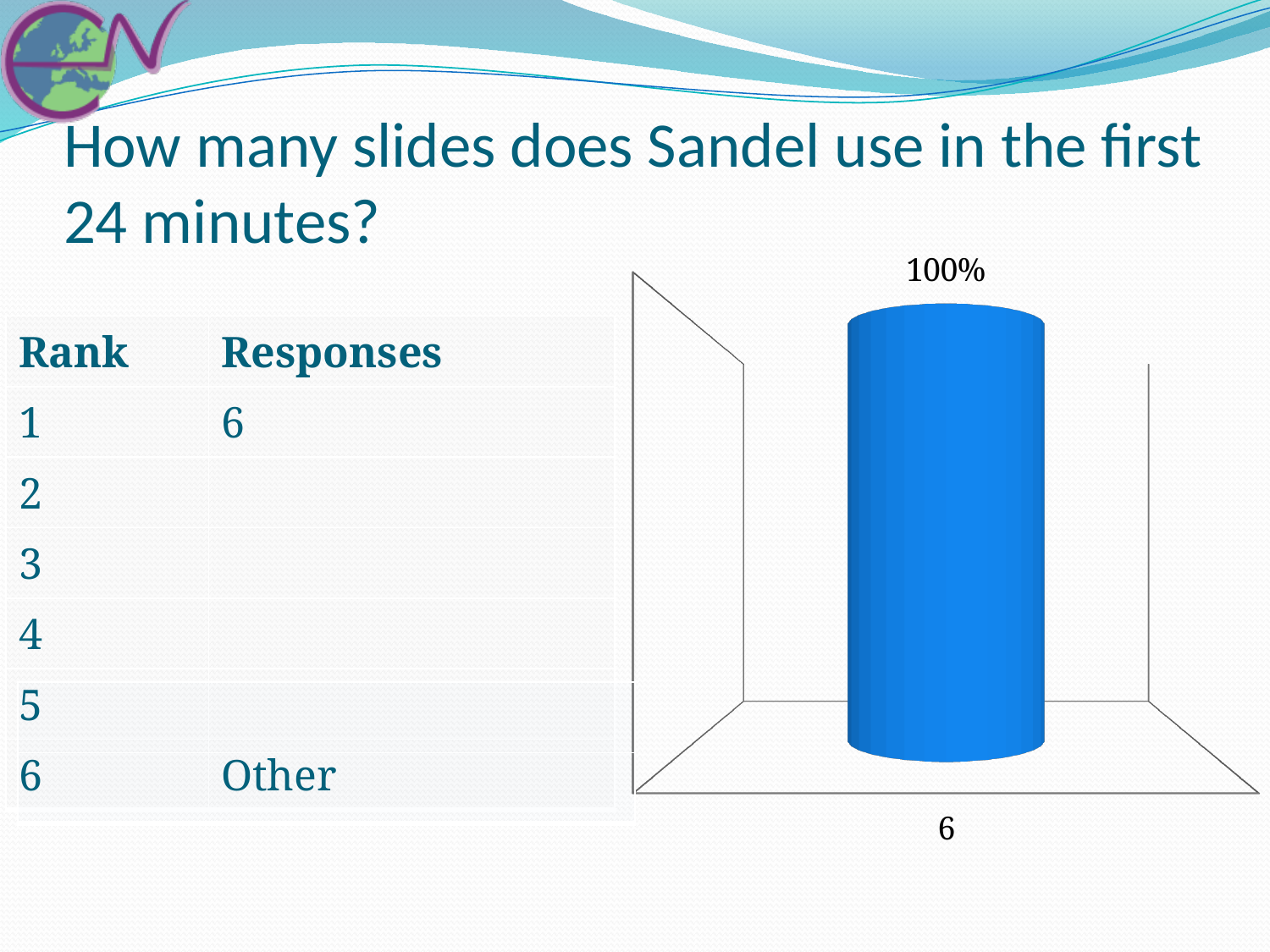
What is the label of the only category on the chart's x axis? 6 What value is shown for the category labelled 6 in the chart? 100% What kind of chart is shown on the slide? bar chart What colour is the bar in the chart? blue Which category has the highest value in the chart? 6 How many bars are plotted in the chart? 1